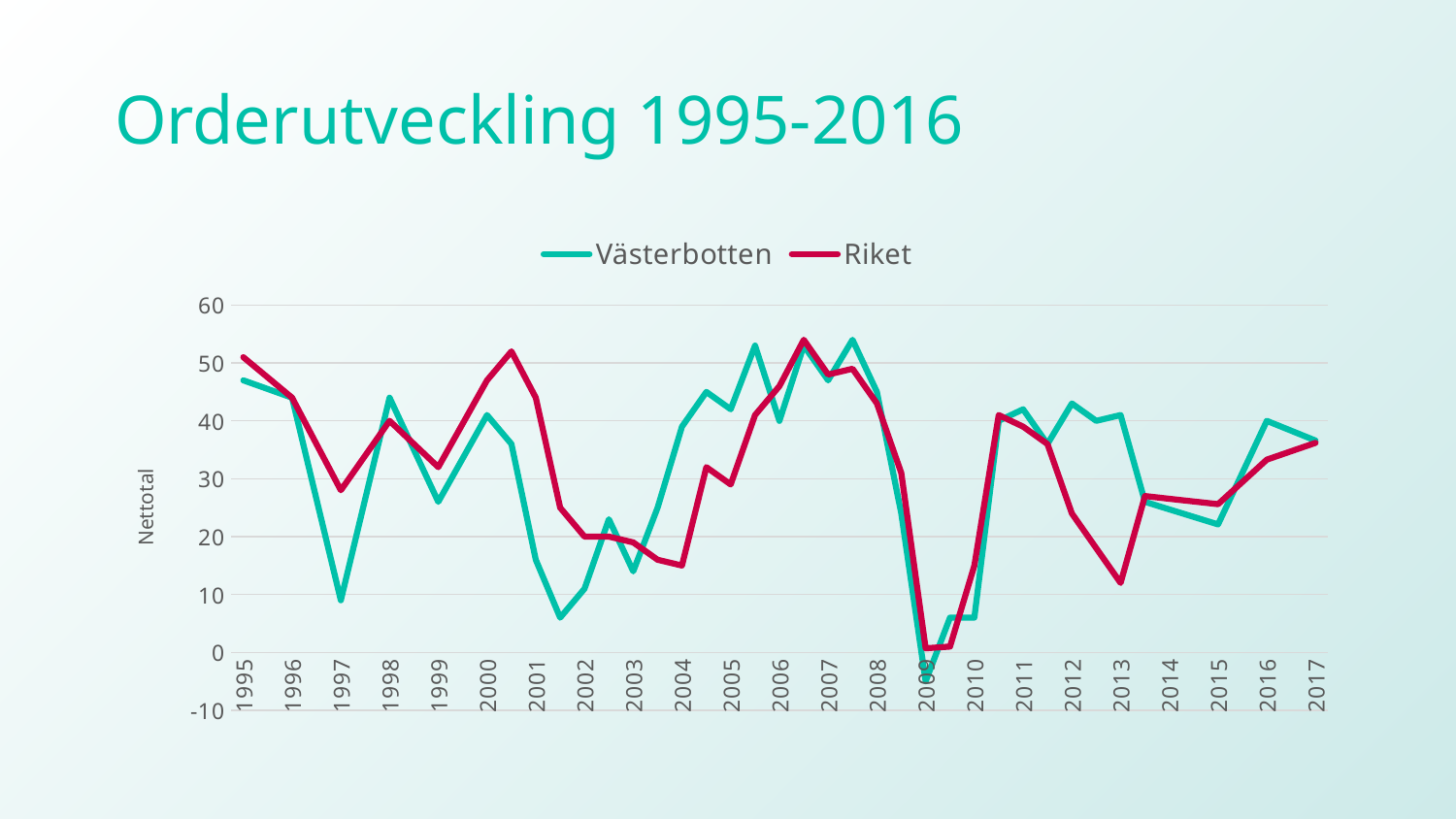
Is the value for Västerbotten in 2009 greater or less than 0? less In 2013, which series has the higher value, Västerbotten or Riket? Västerbotten Is the value for Riket in 2004 greater or less than 20? less What are the two series named in the legend? Västerbotten and Riket What kind of chart is shown on the slide? Line chart Is the value for Riket in 2013 greater or less than 20? less How many series does the legend list? 2 What is the label on the vertical axis? Nettotal In 1997, which series has the higher value, Västerbotten or Riket? Riket Do both lines rise or fall from 2008 to 2009? Fall Does the Riket line rise or fall from 2011 to 2013? Fall